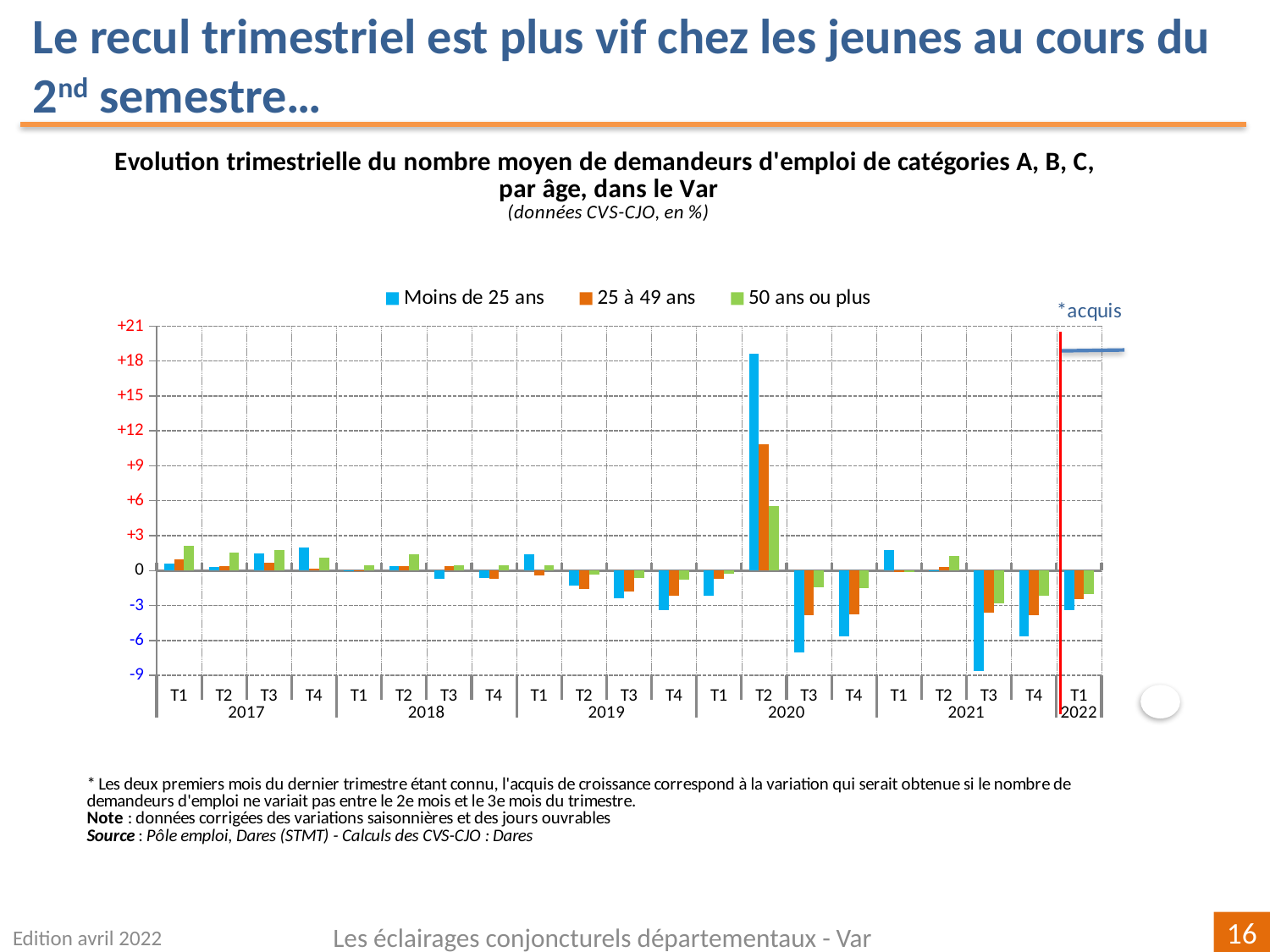
In which quarter does the 'Moins de 25 ans' series reach its highest value? T2 2020 What colour represents the '50 ans ou plus' series in the legend? green In T2 2020, which series has the larger value: 'Moins de 25 ans' or '50 ans ou plus'? Moins de 25 ans In which quarter does the 'Moins de 25 ans' series reach its lowest value? T3 2021 How many quarters are plotted along the x axis? 21 Is the value for 'Moins de 25 ans' in T2 2020 greater or less than +15? greater How many series does the legend list? 3 In T3 2020, which series has the lower value: 'Moins de 25 ans' or '25 à 49 ans'? Moins de 25 ans Is the value for '50 ans ou plus' in T2 2020 greater or less than +3? greater Is the value for '25 à 49 ans' in T2 2020 greater or less than +9? greater What kind of chart is shown on the slide? bar chart